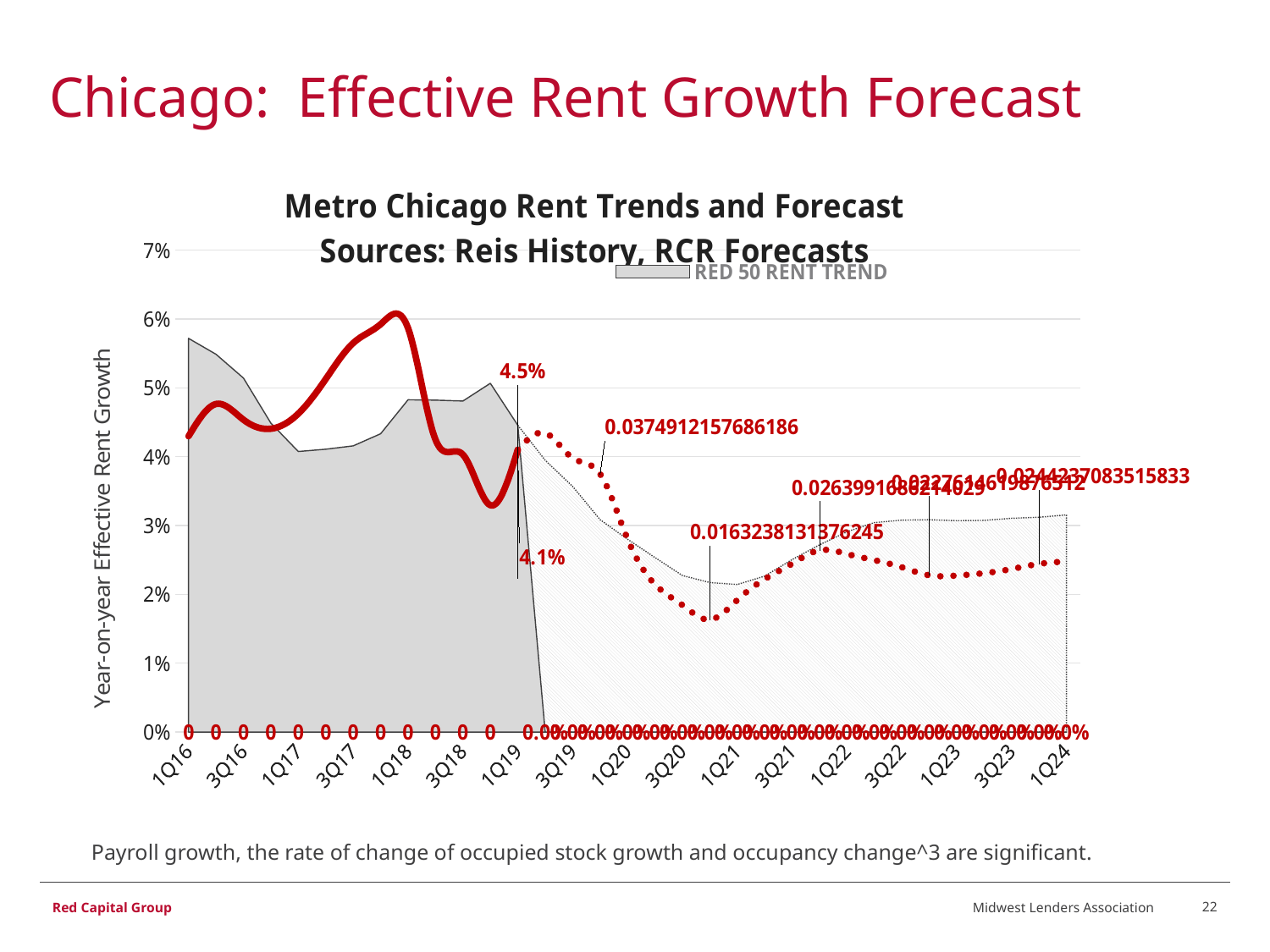
What is the label on the vertical axis of the chart? Year-on-year Effective Rent Growth Is the value of the solid red line at 1Q18 greater or less than 5%? greater What is the highest labelled value on the dotted forecast line? 0.0374912157686186 What kind of chart is shown on the slide? area and line chart How many quarter labels are shown on the x axis? 17 What value is labelled at the end of the dotted forecast line near 1Q24? 0.0244237083515833 Does the dotted forecast line rise or fall between 1Q19 and 1Q21? fall Is the value of the dotted forecast line at 3Q20 greater or less than 2%? less Is the value of the solid red line at 1Q18 higher or lower than at 3Q18? higher What value is labelled on the solid red line at 1Q19? 4.1% What entry does the chart legend list? RED 50 RENT TREND What is the lowest labelled value on the dotted forecast line? 0.0163238131376245